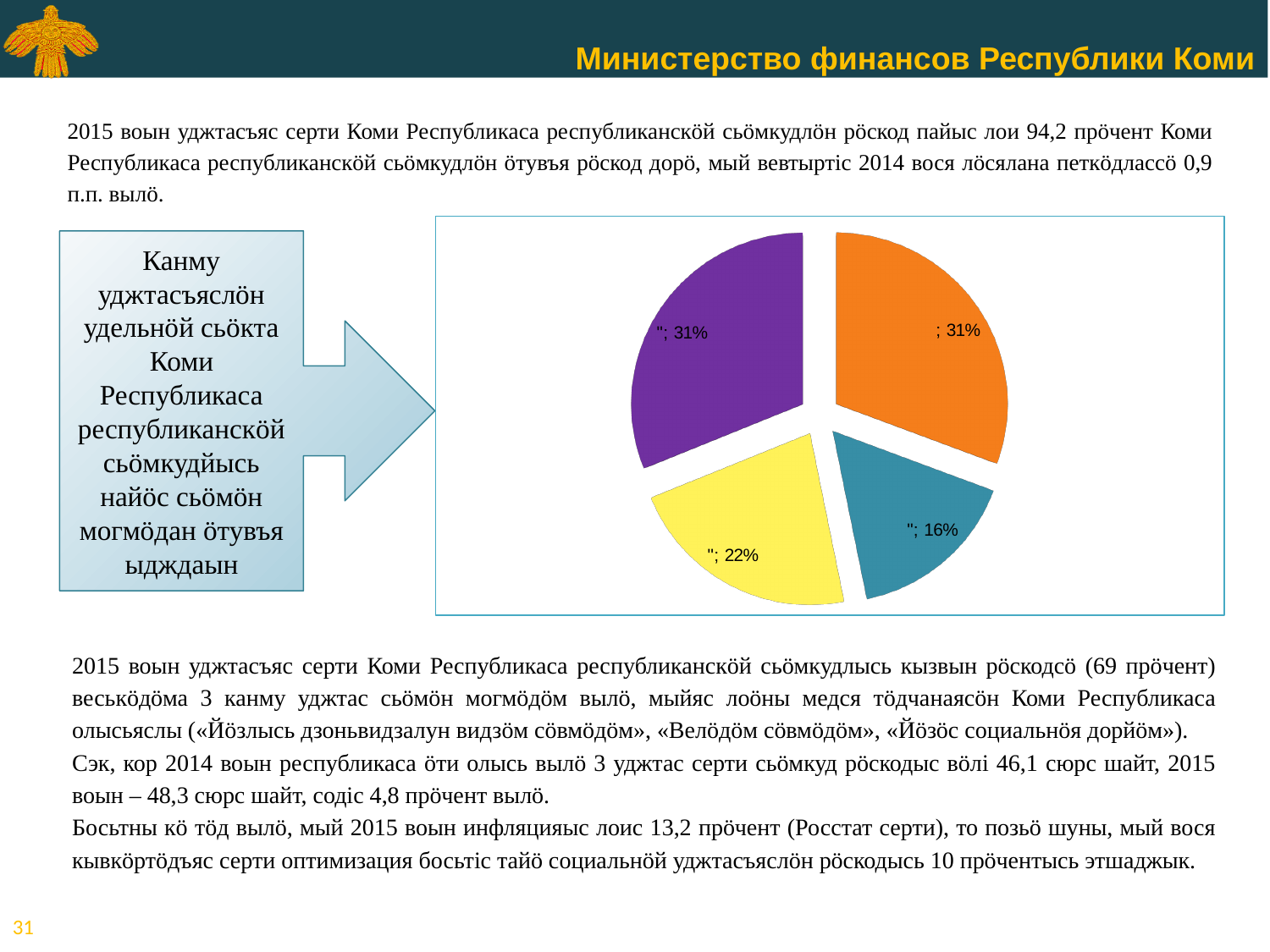
What percentage is shown for the teal (blue-green) slice of the pie chart? 16% What percentage is shown for the yellow slice of the pie chart? 22% Which slice of the pie chart is the smallest? the teal slice (16%) What percentage is shown for the purple slice of the pie chart? 31% What is the difference in percentage points between the orange slice and the teal slice? 15 How many slices of the pie chart show a value of 31%? 2 How many slices does the pie chart have? 4 What percentage is shown for the orange slice of the pie chart? 31% What kind of chart is shown on the slide? pie chart What colour is the slice labelled 22% in the pie chart? yellow What is the difference in percentage points between the yellow slice and the teal slice? 6 Which is larger in the pie chart, the yellow slice or the teal slice? the yellow slice